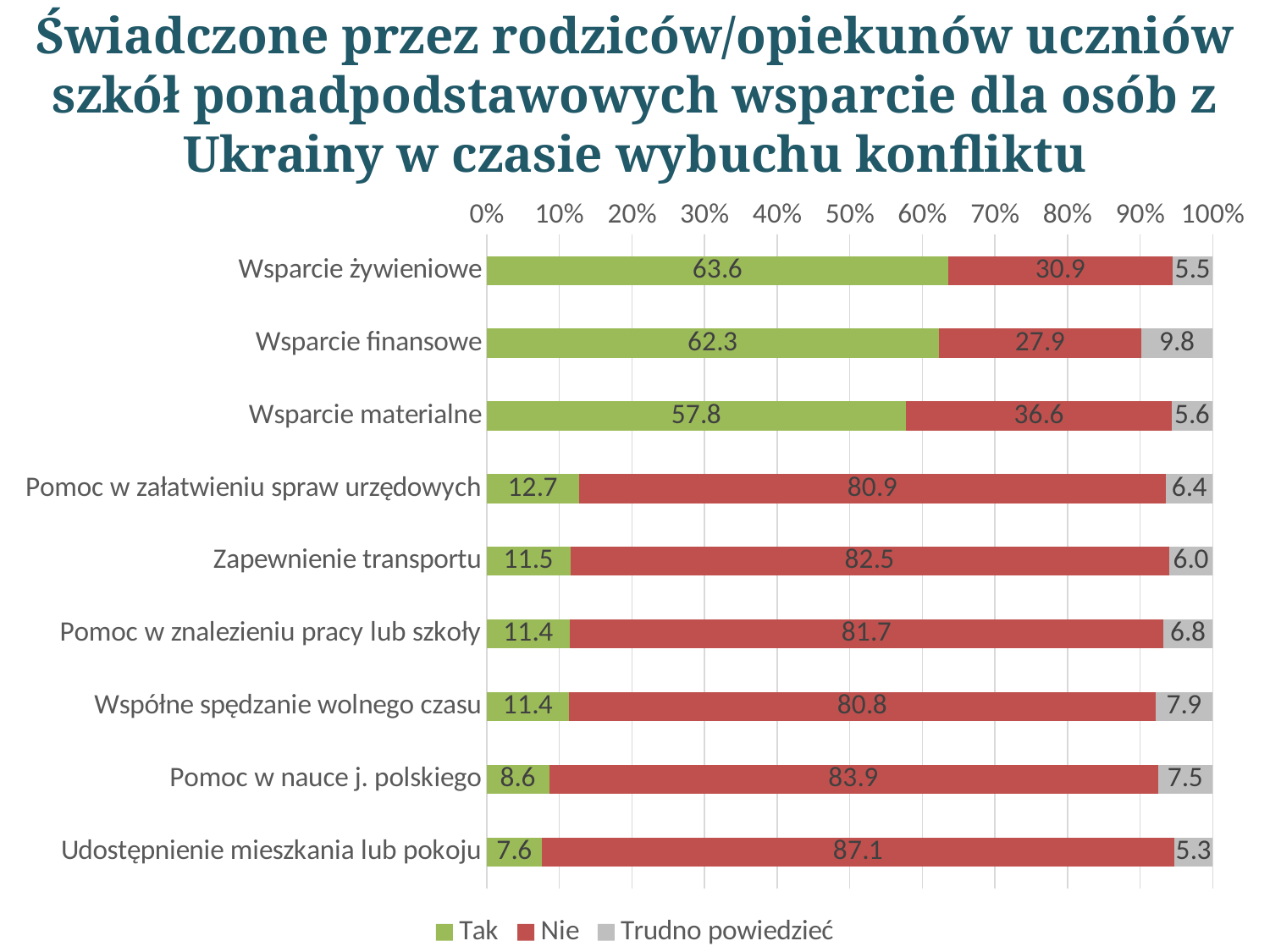
What is the 'Trudno powiedzieć' value for 'Wsparcie finansowe'? 9.8 What is the difference between the 'Tak' values for 'Wsparcie żywieniowe' and 'Wsparcie finansowe'? 1.3 Which category has the lowest 'Tak' value? Udostępnienie mieszkania lub pokoju Which category has the highest 'Tak' value? Wsparcie żywieniowe How many categories are shown on the chart? 9 What is the 'Nie' value for 'Udostępnienie mieszkania lub pokoju'? 87.1 How many series does the legend list? 3 Which is larger: the 'Nie' value for 'Zapewnienie transportu' or for 'Pomoc w załatwieniu spraw urzędowych'? Zapewnienie transportu What kind of chart is shown on the slide? Stacked bar chart What is the 'Tak' value for 'Wsparcie żywieniowe'? 63.6 Which category has the highest 'Nie' value? Udostępnienie mieszkania lub pokoju What is the total of the stacked bar for 'Wsparcie materialne'? 100